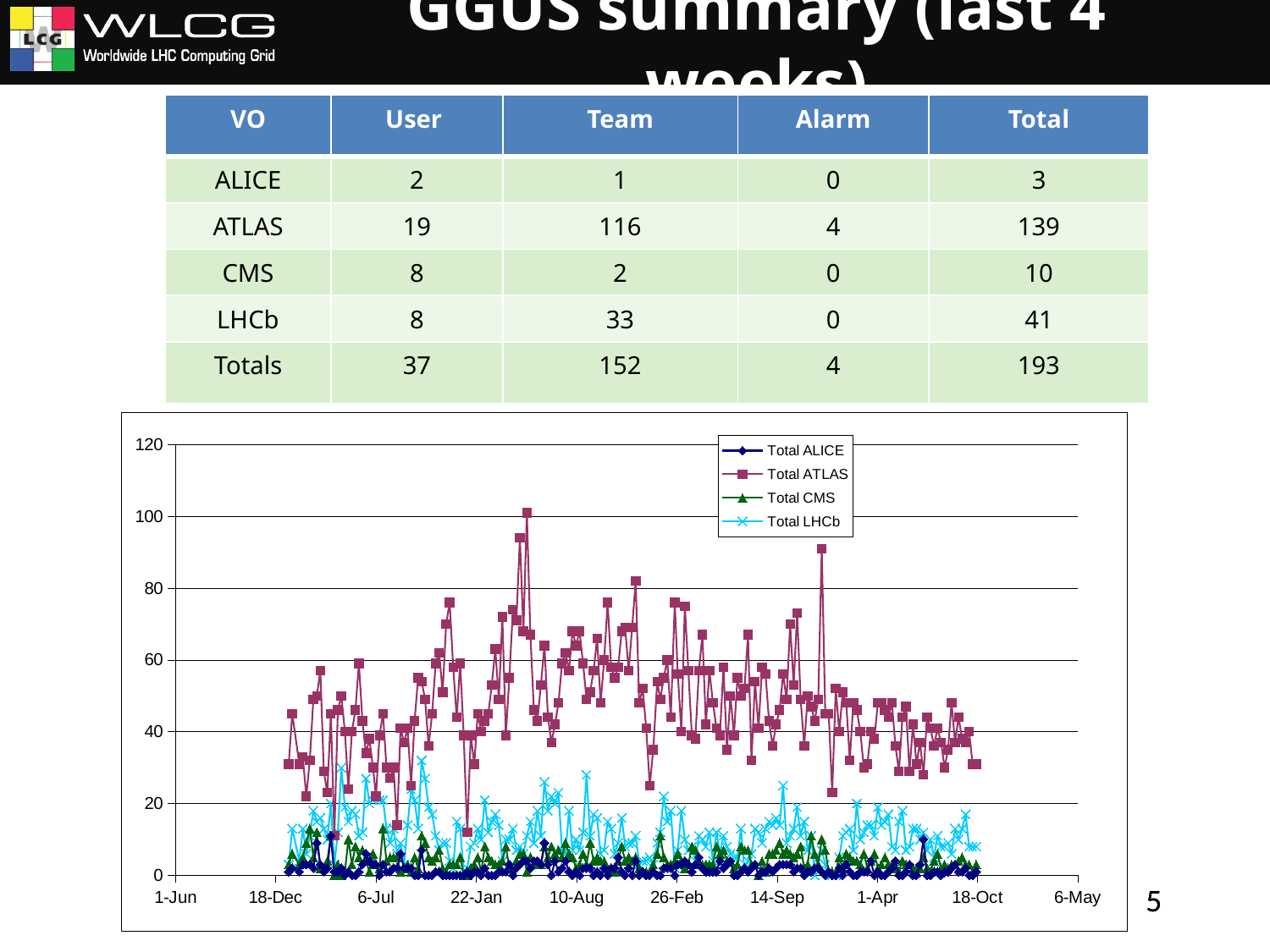
What kind of chart is shown at the bottom of the slide? line chart Is the highest value of the Total LHCb series greater or less than 40? less Which series in the chart has the highest values overall? Total ATLAS Which series generally has larger values, Total LHCb or Total ALICE? Total LHCb Which series generally has larger values, Total ATLAS or Total CMS? Total ATLAS How many series does the chart's legend list? 4 What is the first date label on the chart's x axis? 1-Jun How many date labels are shown on the chart's x axis? 10 Is the peak value of the Total ATLAS series greater or less than 80? greater Which series in the chart stays lowest across the whole period? Total ALICE What is the highest tick value shown on the chart's y axis? 120 Is the highest value of the Total ALICE series greater or less than 20? less